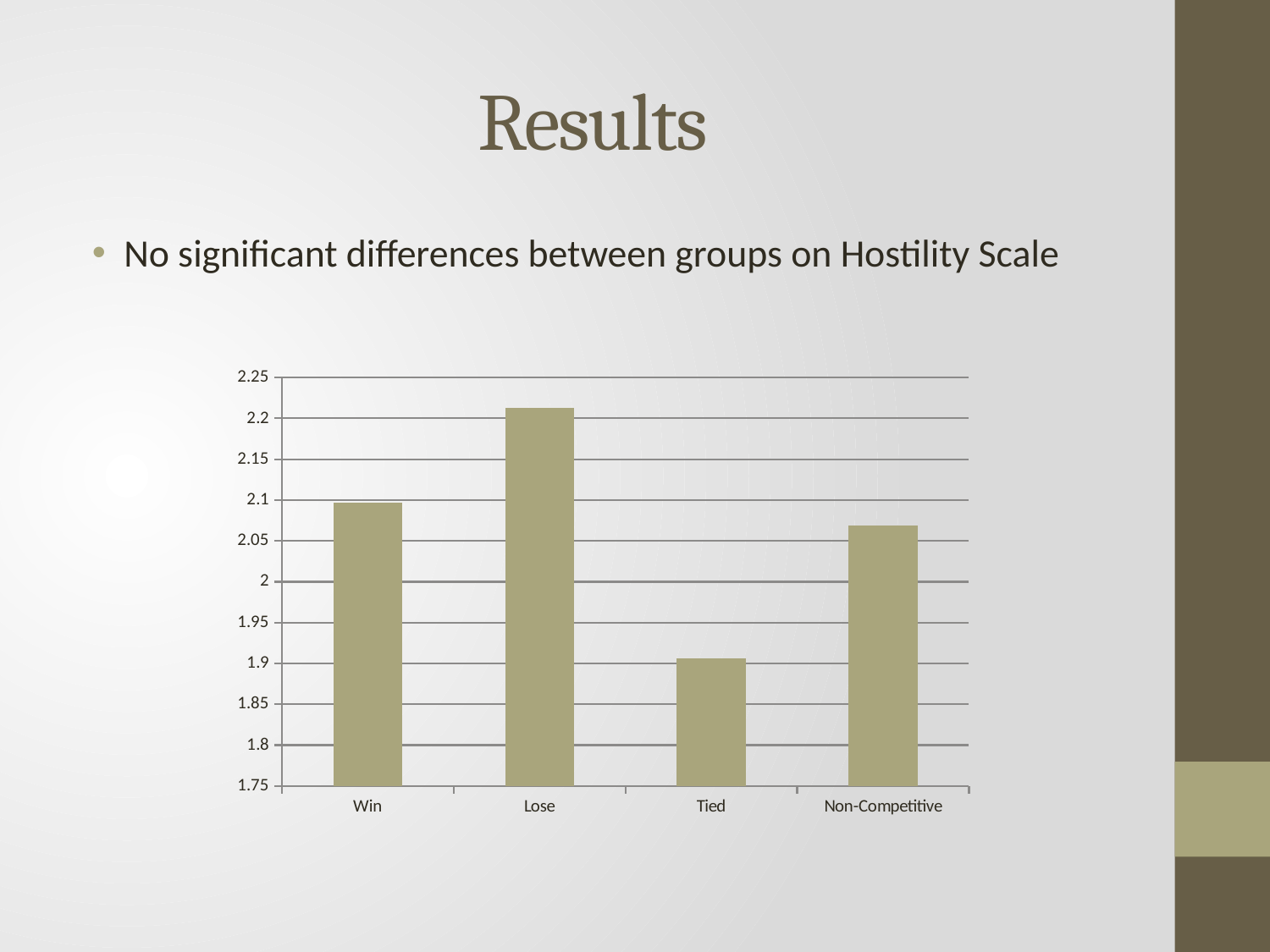
Which is larger, the value for Lose or the value for Win? Lose What kind of chart is shown on the slide? bar chart What is the lowest value shown on the chart's vertical axis? 1.75 Which category has the highest bar in the chart? Lose Is the value for Tied greater or less than 1.95? less How many categories are shown on the x axis of the chart? 4 Which is larger, the value for Tied or the value for Non-Competitive? Non-Competitive What is the highest value shown on the chart's vertical axis? 2.25 Is the value for Lose greater or less than 2.15? greater Which category has the lowest bar in the chart? Tied Is the value for Win greater or less than 2.05? greater